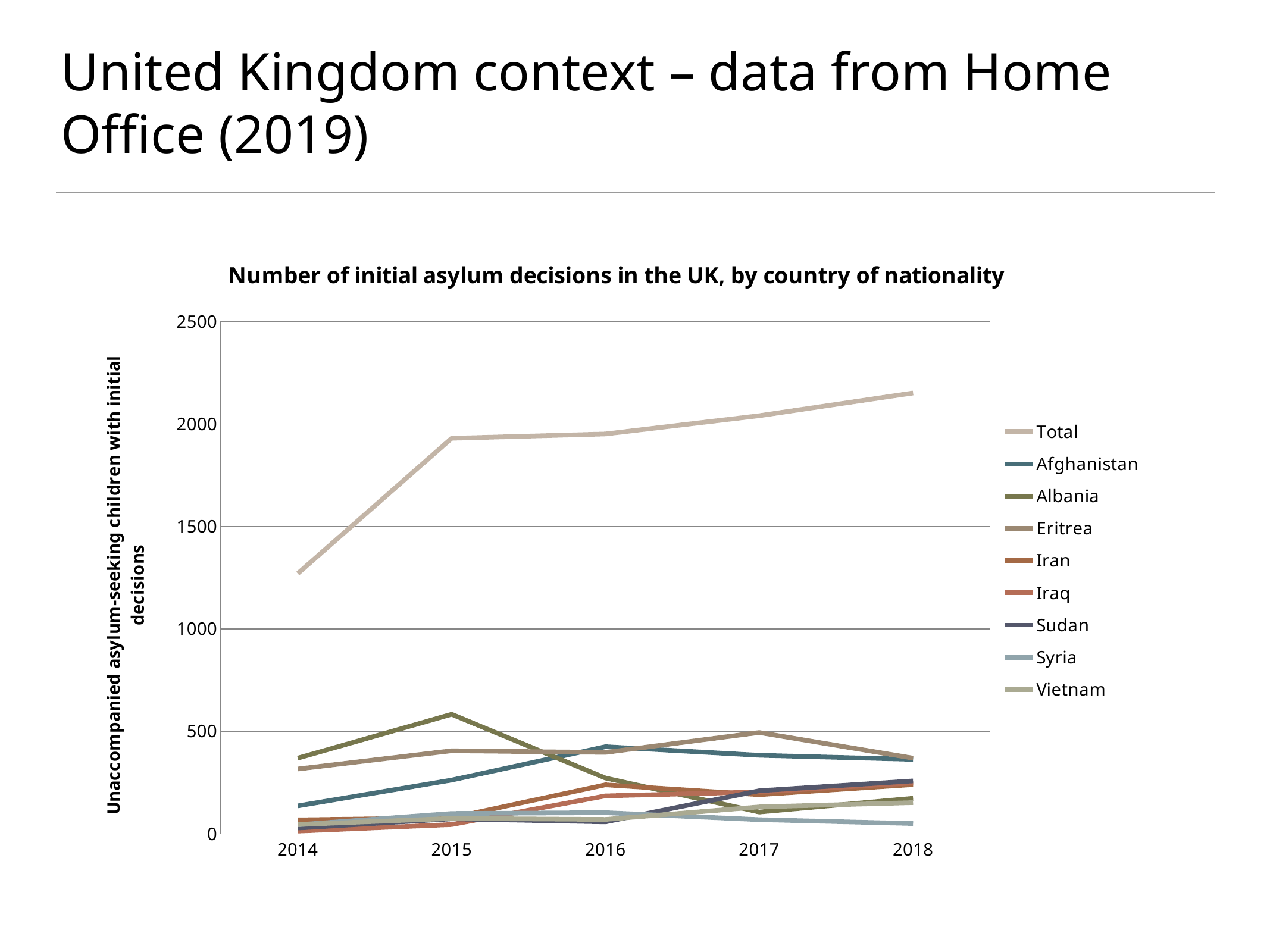
What kind of chart is shown on the slide? line chart In which year is the Albania line at its lowest? 2017 In 2017, which is larger, the value for Eritrea or the value for Afghanistan? Eritrea Excluding Total, which country has the highest value in 2015? Albania How many years are shown on the x axis? 5 How many series does the legend list? 9 Is the Total value for 2018 greater or less than 2000? greater Does the Total line rise or fall from 2014 to 2018? rise What is the title of the chart? Number of initial asylum decisions in the UK, by country of nationality In which year is the Albania line at its highest? 2015 Is the Total value for 2014 greater or less than 1500? less Is the value for Albania in 2015 greater or less than 500? greater